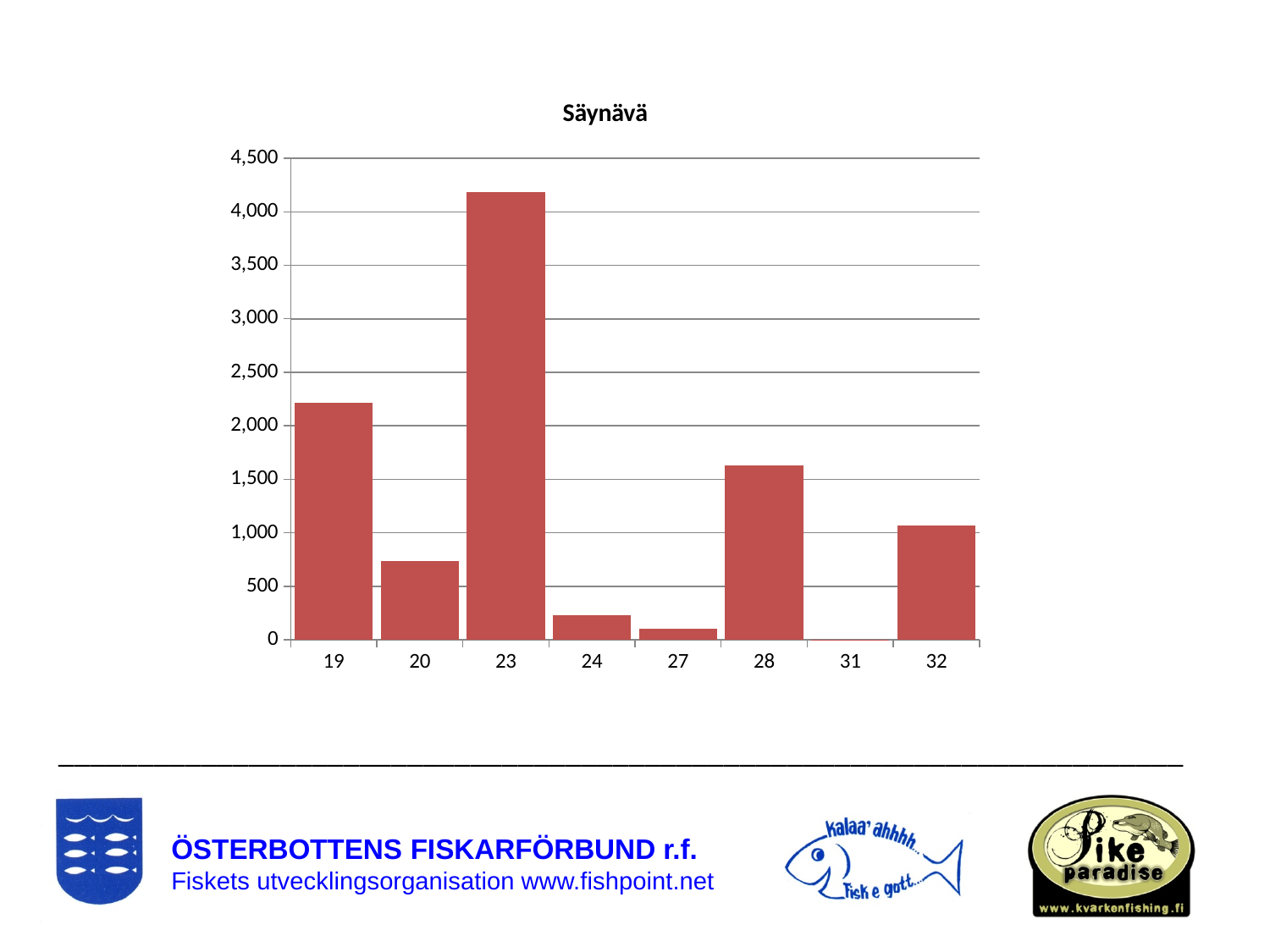
How many categories are shown on the x axis of the chart? 8 Which category has the larger value, 19 or 28? 19 Is the value for category 28 greater or less than 1,500? greater Is the value for category 19 greater or less than 2,000? greater Is the value for category 23 greater or less than 4,000? greater Which category has the highest bar in the chart? 23 What kind of chart is shown on the slide? bar chart What is the title of the chart? Säynävä Which category has the larger value, 20 or 32? 32 Which category has the lowest bar in the chart? 31